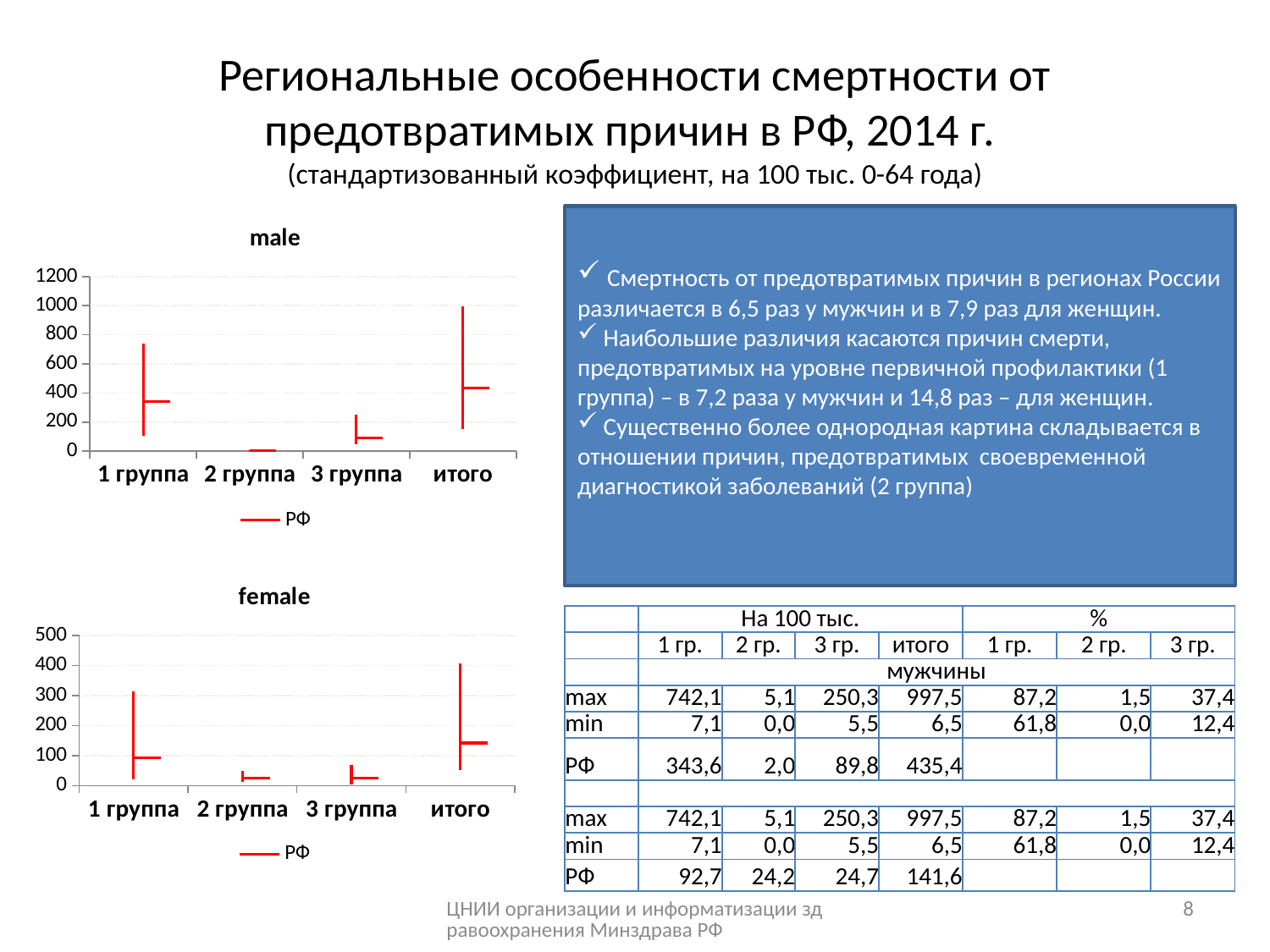
In the male chart, which category has the highest РФ value? итого In the male chart, is the РФ value for 1 группа greater or less than 200? greater In the female chart, which category has the highest РФ value? итого What is the highest value shown on the vertical axis of the female chart? 500 In the female chart, is the РФ value for итого greater or less than 100? greater In the male chart, which category has the lowest РФ value? 2 группа In the male chart, how many categories are shown on the x axis? 4 In the female chart, how many series does the legend list? 1 In the male chart, is the РФ value for 3 группа greater or less than 200? less In the male chart, what is the name of the series shown in the legend? РФ In the male chart, which has the larger РФ value, 1 группа or 3 группа? 1 группа